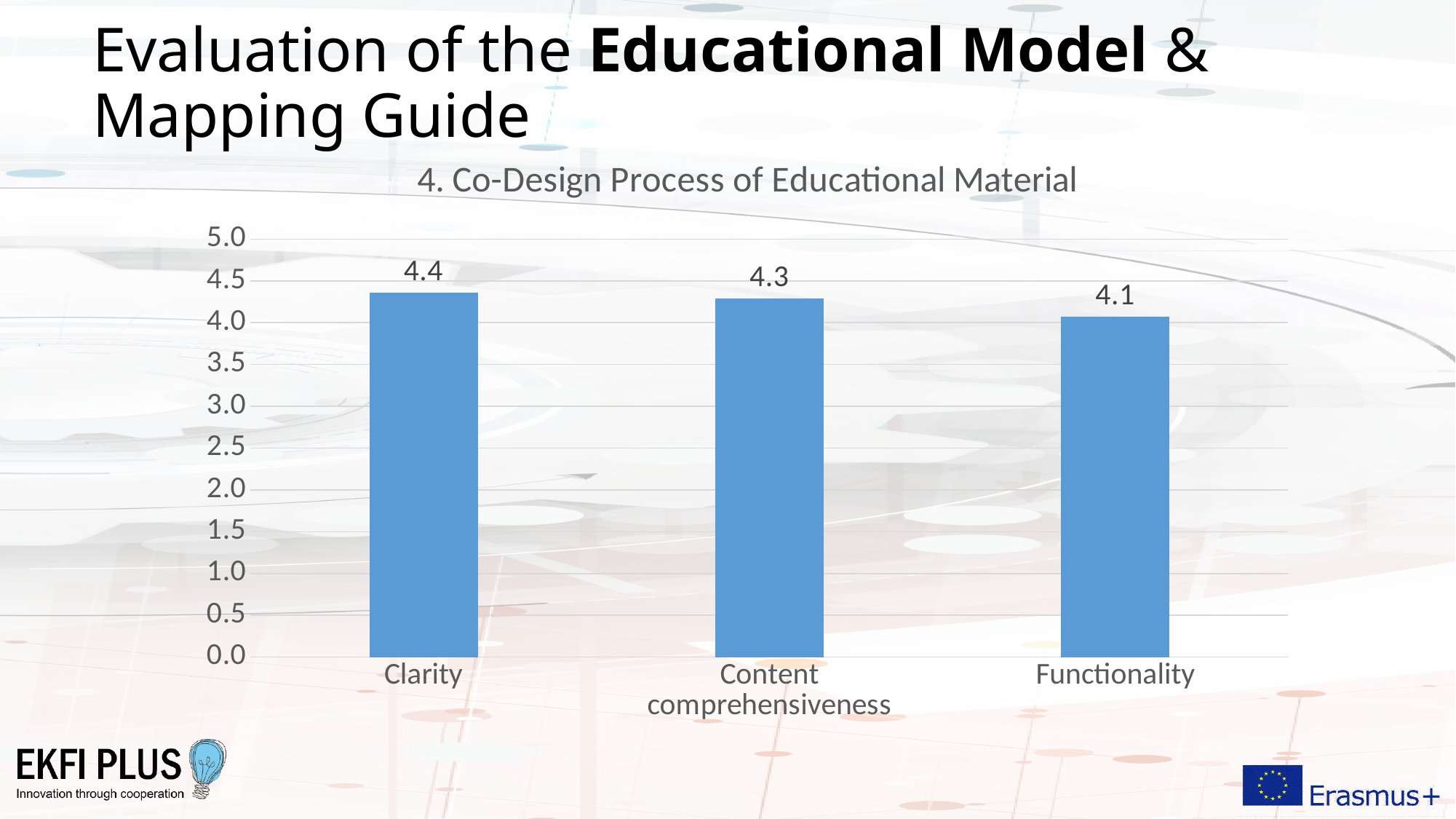
What kind of chart is shown on the slide? Bar chart What is the difference between the values for Clarity and Functionality? 0.3 What is the value for Functionality? 4.1 Is the value for Functionality greater or less than 4.0? greater How many categories are shown in the chart? 3 What is the value for Content comprehensiveness? 4.3 What is the title of the chart? 4. Co-Design Process of Educational Material Which is larger, the value for Clarity or the value for Functionality? Clarity What is the difference between the values for Content comprehensiveness and Functionality? 0.2 Which category has the highest value? Clarity What is the value for Clarity? 4.4 Which category has the lowest value? Functionality